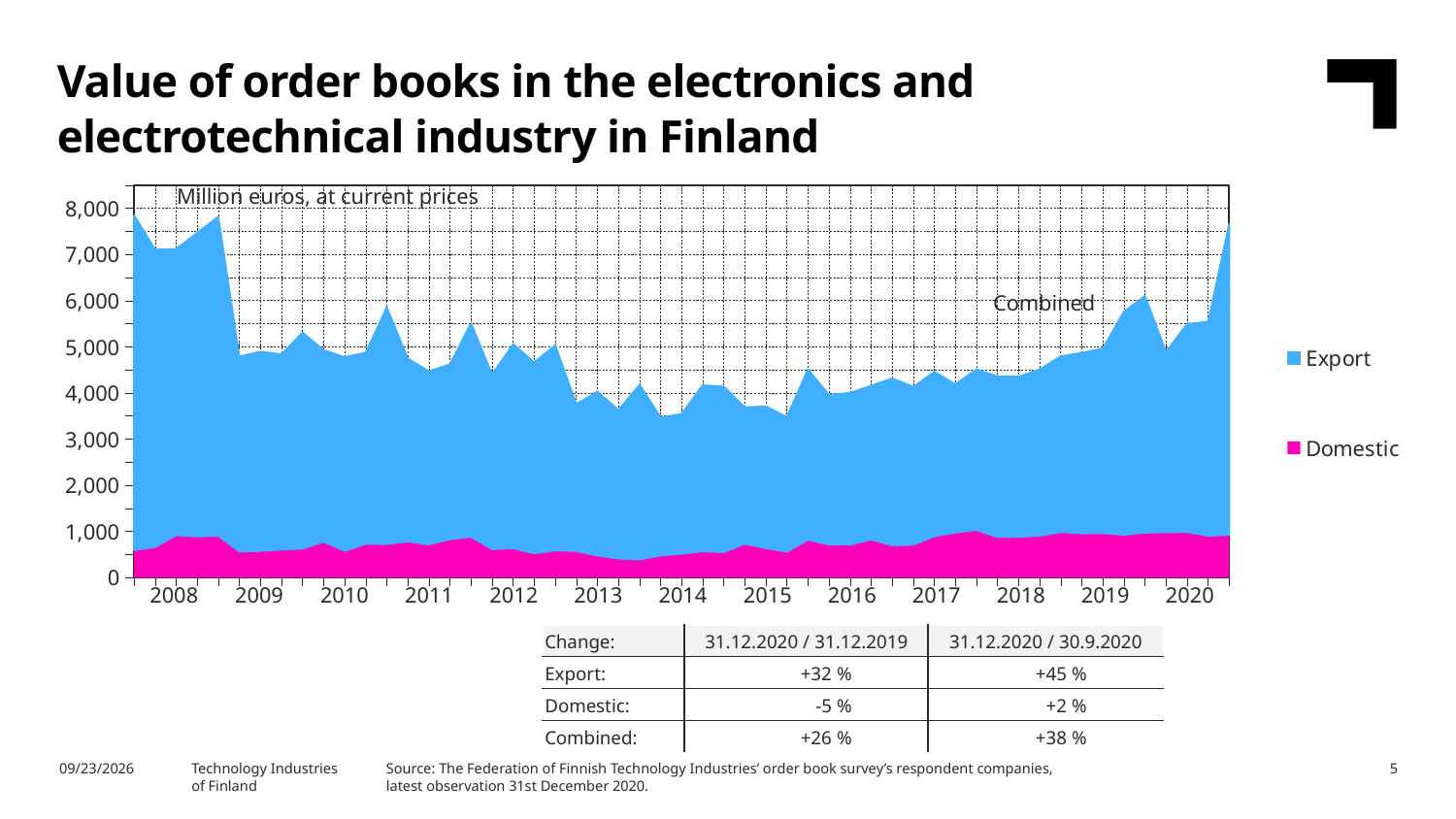
Is the combined value at the start of 2008 greater or less than 7,000? greater What unit is stated in the chart's subtitle? Million euros, at current prices Does the combined value generally rise or fall from 2008 to 2015? fall Is the combined value during 2015 greater or less than 5,000? less What are the two series named in the chart legend? Export and Domestic How many series does the chart legend list? 2 Is the combined value during 2010 greater or less than 6,000? less How many years are labelled on the x axis? 13 What type of chart is shown on the slide? Area chart Which series, Export or Domestic, has the larger values throughout the chart? Export